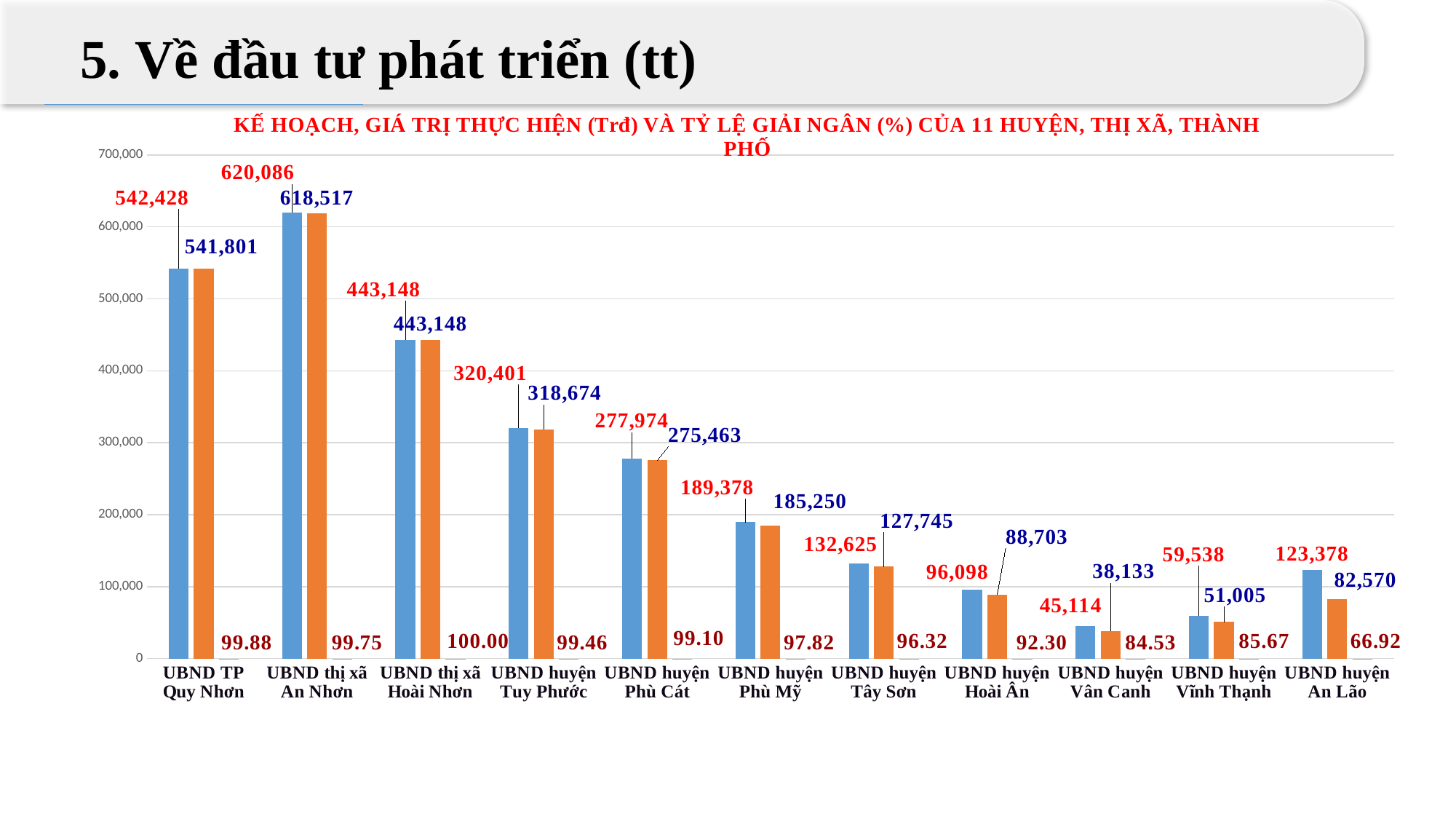
What is the percentage value shown at the base of the bars for UBND thị xã Hoài Nhơn? 100.00 What is the blue data label value for UBND huyện An Lão? 82,570 How many categories (localities) are shown along the x axis of the chart? 11 Which has the larger red data label value: UBND huyện Vân Canh or UBND huyện Vĩnh Thạnh? UBND huyện Vĩnh Thạnh Is the value of the blue bar for UBND huyện Tuy Phước greater or less than 300,000? greater What is the red data label value for UBND TP Quy Nhơn? 542,428 Do the blue bars rise or fall along the x axis from UBND thị xã An Nhơn to UBND huyện Vân Canh? fall What is the difference between the red data label (123,378) and the blue data label (82,570) for UBND huyện An Lão? 40,808 What is the difference between the red data label (277,974) and the blue data label (275,463) for UBND huyện Phù Cát? 2,511 What kind of chart is shown on the slide? bar chart Which locality has the lowest percentage value shown at the base of its bars? UBND huyện An Lão Which locality has the tallest blue bar? UBND thị xã An Nhơn